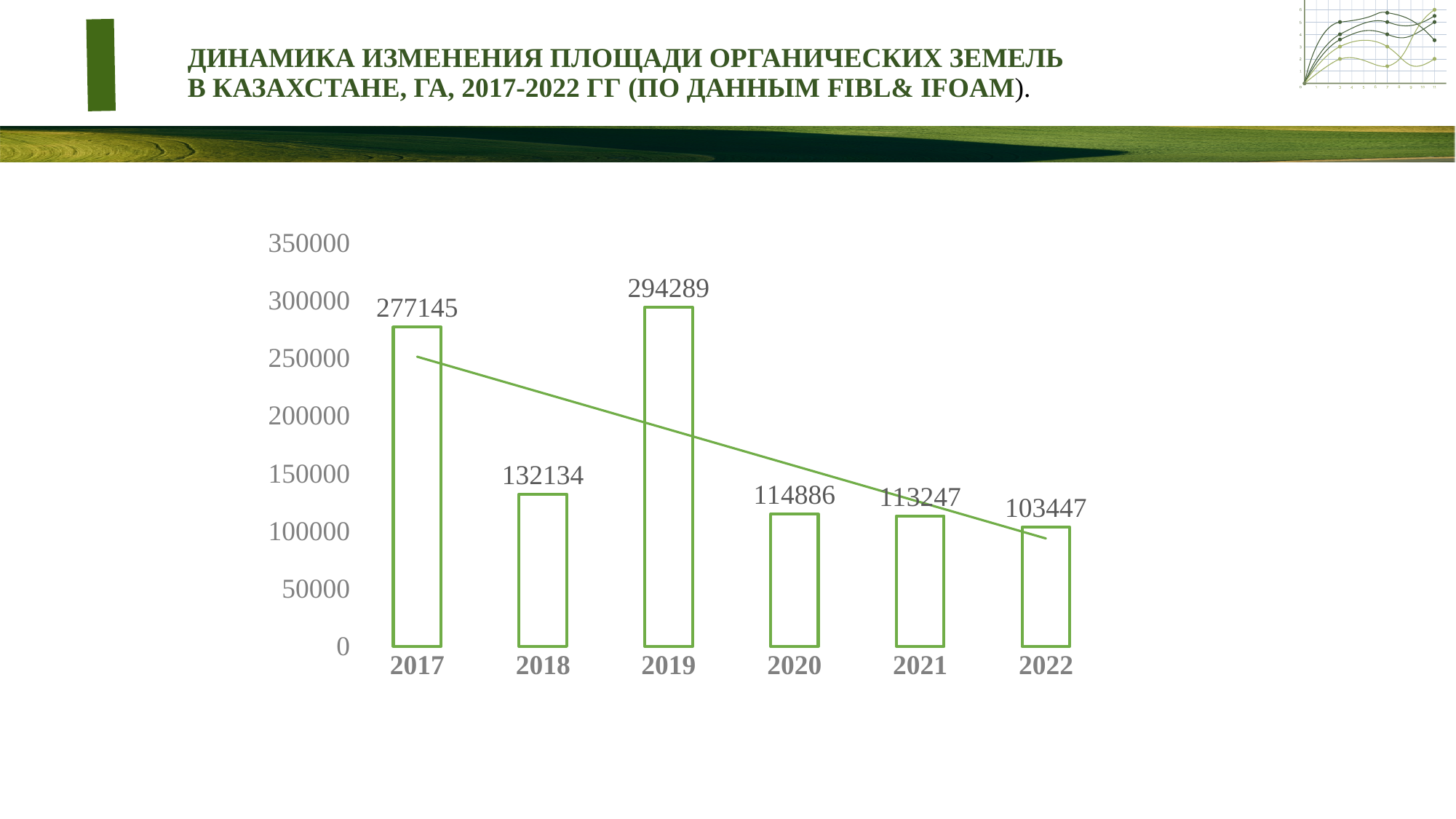
What is the difference between the values for 2018 and 2022? 28687 What is the value for 2017? 277145 What kind of chart is shown on the slide? bar chart What is the value for 2020? 114886 Which year has the highest value? 2019 Which year has the lowest value? 2022 Which is larger, the value for 2020 or the value for 2021? 2020 What is the difference between the values for 2019 and 2017? 17144 What is the value for 2019? 294289 Is the value for 2018 greater or less than 150000? less How many years are shown on the x axis? 6 What is the value for 2022? 103447